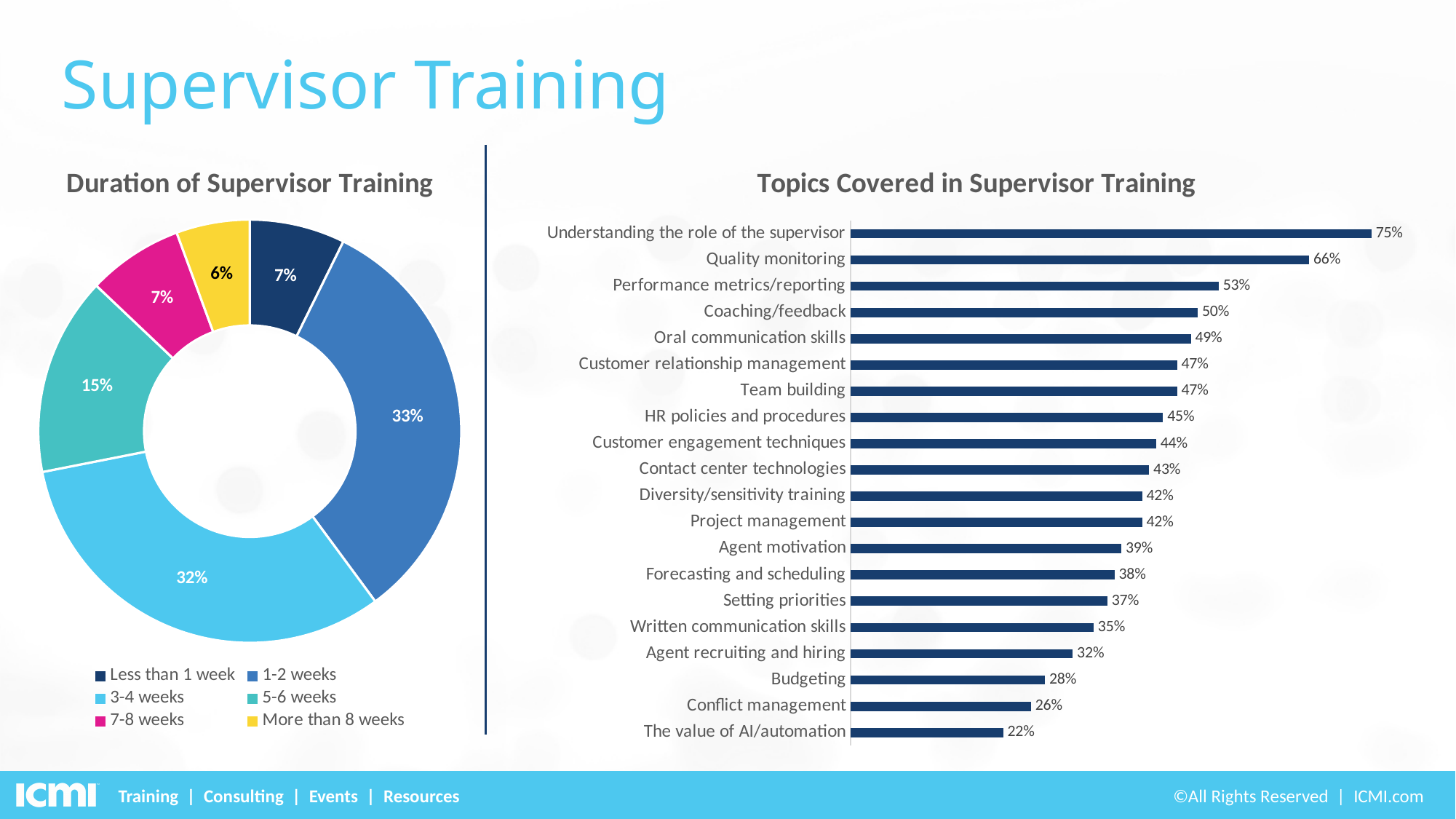
In the 'Duration of Supervisor Training' chart, which duration category has the smallest share? More than 8 weeks In the 'Topics Covered in Supervisor Training' chart, which topic has the highest value? Understanding the role of the supervisor In the 'Topics Covered in Supervisor Training' chart, what is the difference between Understanding the role of the supervisor and Quality monitoring? 9% In the 'Topics Covered in Supervisor Training' chart, which is larger: Budgeting or Conflict management? Budgeting In the 'Duration of Supervisor Training' chart, what percentage corresponds to 5-6 weeks? 15% In the 'Topics Covered in Supervisor Training' chart, which topic has the lowest value? The value of AI/automation How many topics are shown in the 'Topics Covered in Supervisor Training' chart? 20 In the 'Topics Covered in Supervisor Training' chart, what is the value for Quality monitoring? 66% What kind of chart is 'Topics Covered in Supervisor Training'? Bar chart What kind of chart is 'Duration of Supervisor Training'? Donut (pie) chart How many categories does the legend of the 'Duration of Supervisor Training' chart list? 6 In the 'Duration of Supervisor Training' chart, what share of respondents reported 1-2 weeks of training? 33%